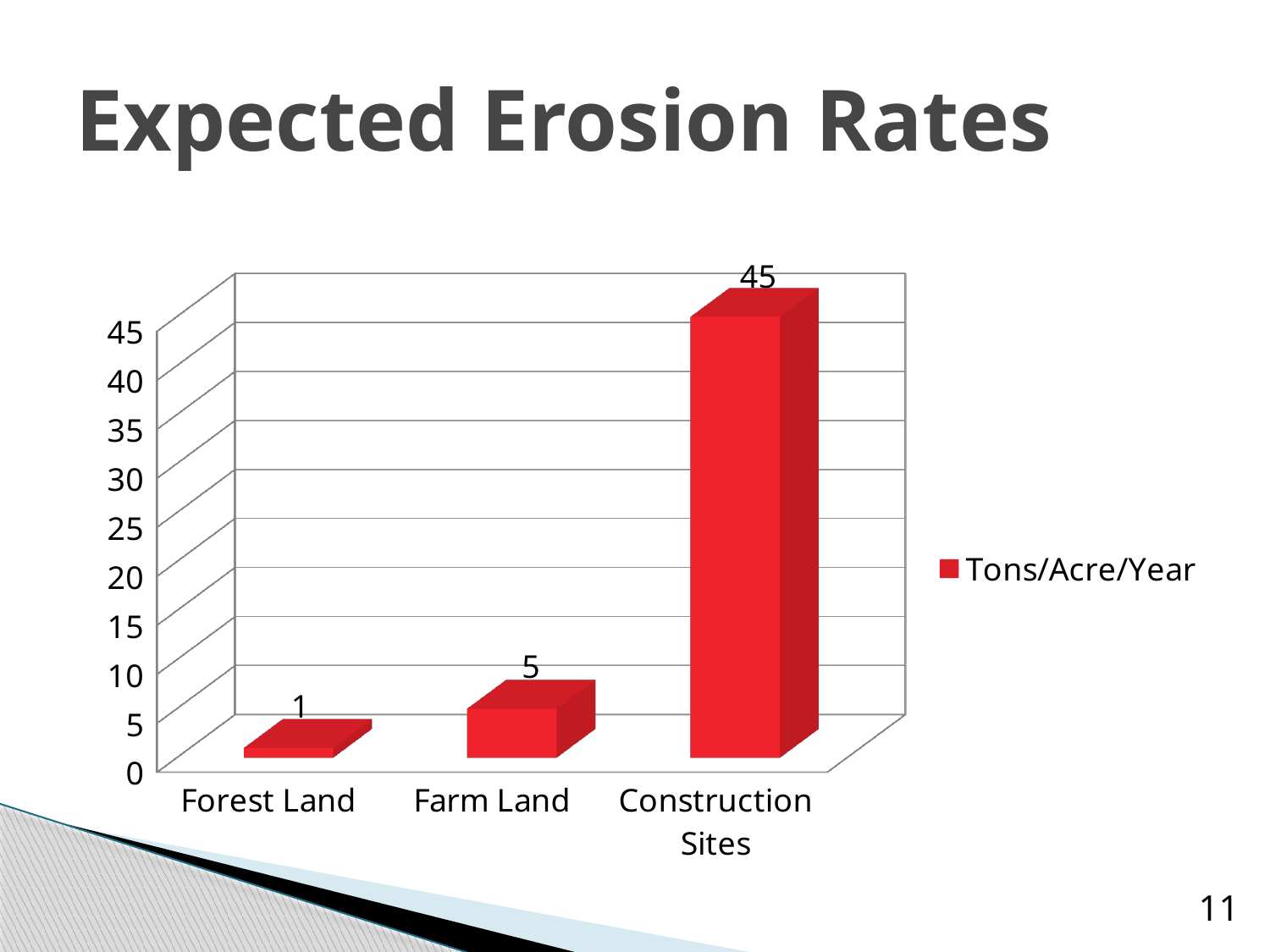
What is the difference between the values for Construction Sites and Farm Land? 40 What kind of chart is shown on the slide? bar chart What series name does the legend show? Tons/Acre/Year Which is larger, the value for Farm Land or the value for Forest Land? Farm Land What is the value for Construction Sites? 45 What is the value for Farm Land? 5 What is the difference between the values for Farm Land and Forest Land? 4 Which category has the lowest value? Forest Land Is the value for Construction Sites greater or less than 40? greater What is the value for Forest Land? 1 Which category has the highest value? Construction Sites How many categories are shown on the x axis? 3